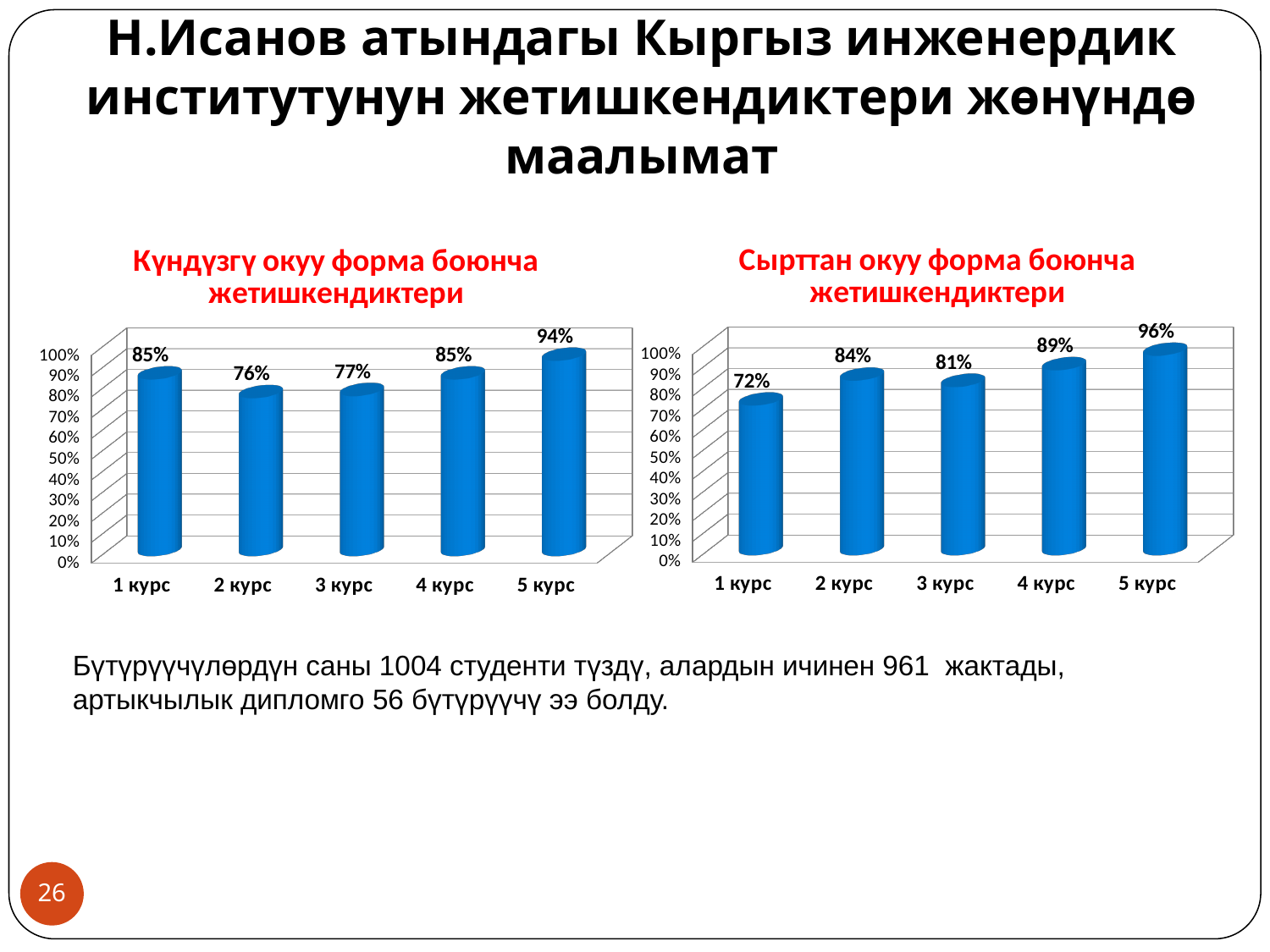
In the left chart (Күндүзгү окуу форма боюнча жетишкендиктери), what is the value for 2 курс? 76% What kind of chart is the left chart (Күндүзгү окуу форма боюнча жетишкендиктери)? Bar chart In the right chart (Сырттан окуу форма боюнча жетишкендиктери), which course has the lowest value? 1 курс In the right chart (Сырттан окуу форма боюнча жетишкендиктери), which is larger, the value for 2 курс or 3 курс? 2 курс In the right chart (Сырттан окуу форма боюнча жетишкендиктери), what is the value for 1 курс? 72% In the right chart (Сырттан окуу форма боюнча жетишкендиктери), what is the difference between the values for 4 курс and 3 курс? 8% How many courses are shown in the right chart (Сырттан окуу форма боюнча жетишкендиктери)? 5 In the left chart (Күндүзгү окуу форма боюнча жетишкендиктери), which course has the highest value? 5 курс What is the title of the left chart? Күндүзгү окуу форма боюнча жетишкендиктери In the left chart (Күндүзгү окуу форма боюнча жетишкендиктери), what is the difference between the values for 5 курс and 2 курс? 18% In the left chart (Күндүзгү окуу форма боюнча жетишкендиктери), is the value for 3 курс greater or less than 80%? less In the right chart (Сырттан окуу форма боюнча жетишкендиктери), what is the value for 5 курс? 96%